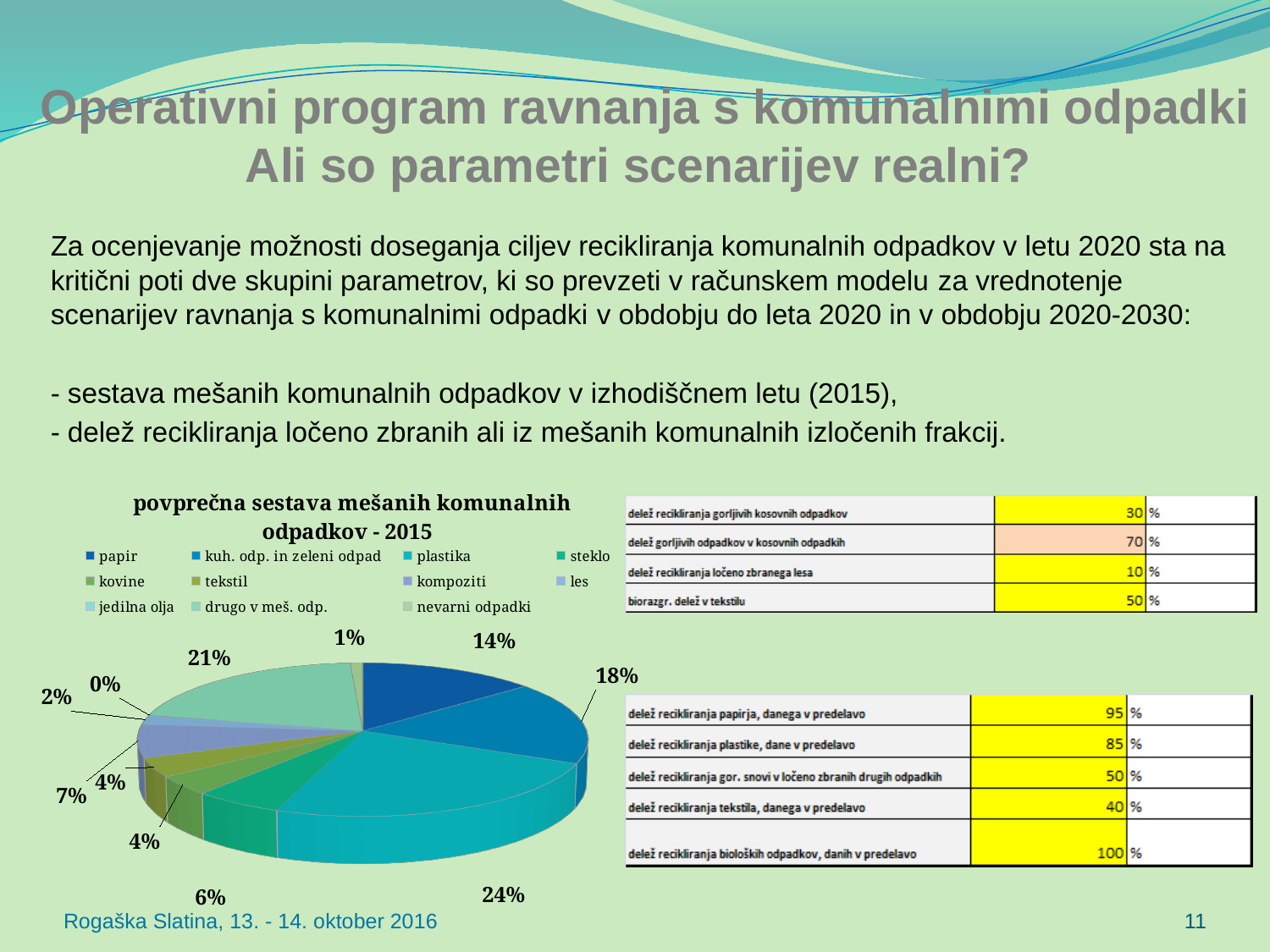
What is the difference between the plastika and papir shares in the pie chart? 10 percentage points What kind of chart is shown on the slide? pie chart What is the title of the pie chart? povprečna sestava mešanih komunalnih odpadkov - 2015 What is the value shown for kuh. odp. in zeleni odpad in the pie chart? 18% What share of the pie does plastika have? 24% Which category has the largest slice in the pie chart? plastika Which is larger in the pie chart, plastika or papir? plastika What is the difference between the drugo v meš. odp. and kuh. odp. in zeleni odpad shares in the pie chart? 3 percentage points How many categories does the pie chart's legend list? 11 What is the value shown for papir in the pie chart? 14% What is the smallest percentage labelled on the pie chart? 0% What is the value shown for drugo v meš. odp. in the pie chart? 21%